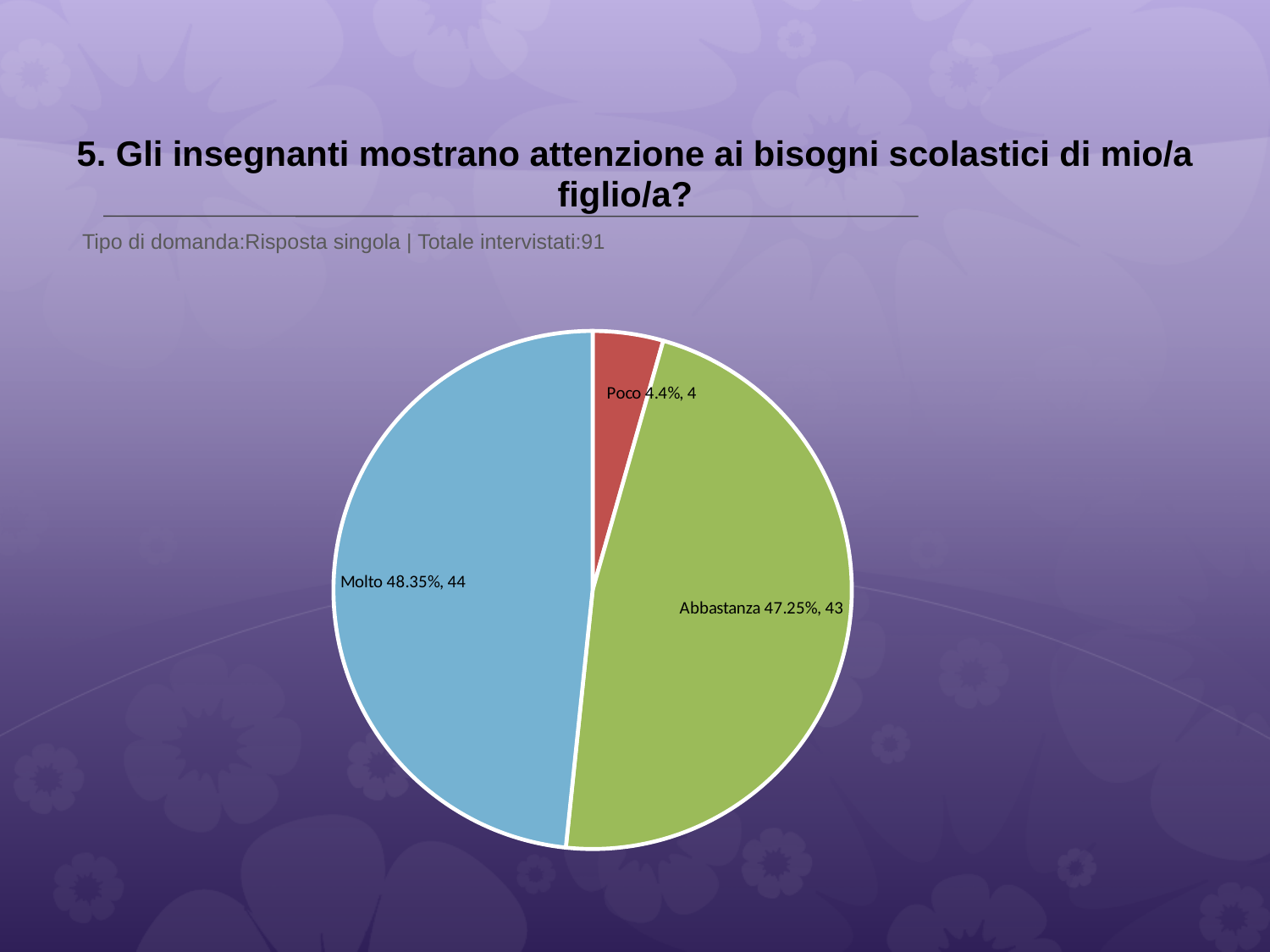
What colour is the Abbastanza slice? green Which category has the smallest slice? Poco How many respondents answered Abbastanza? 43 What percentage share does the Poco slice have? 4.4% What percentage share does the Molto slice have? 48.35% What percentage share does the Abbastanza slice have? 47.25% How many slices does the pie chart have? 3 What is the difference in respondent count between Molto and Poco? 40 How many respondents answered Poco? 4 How many respondents answered Molto? 44 What kind of chart is shown on the slide? pie chart What is the total number of respondents across all slices? 91